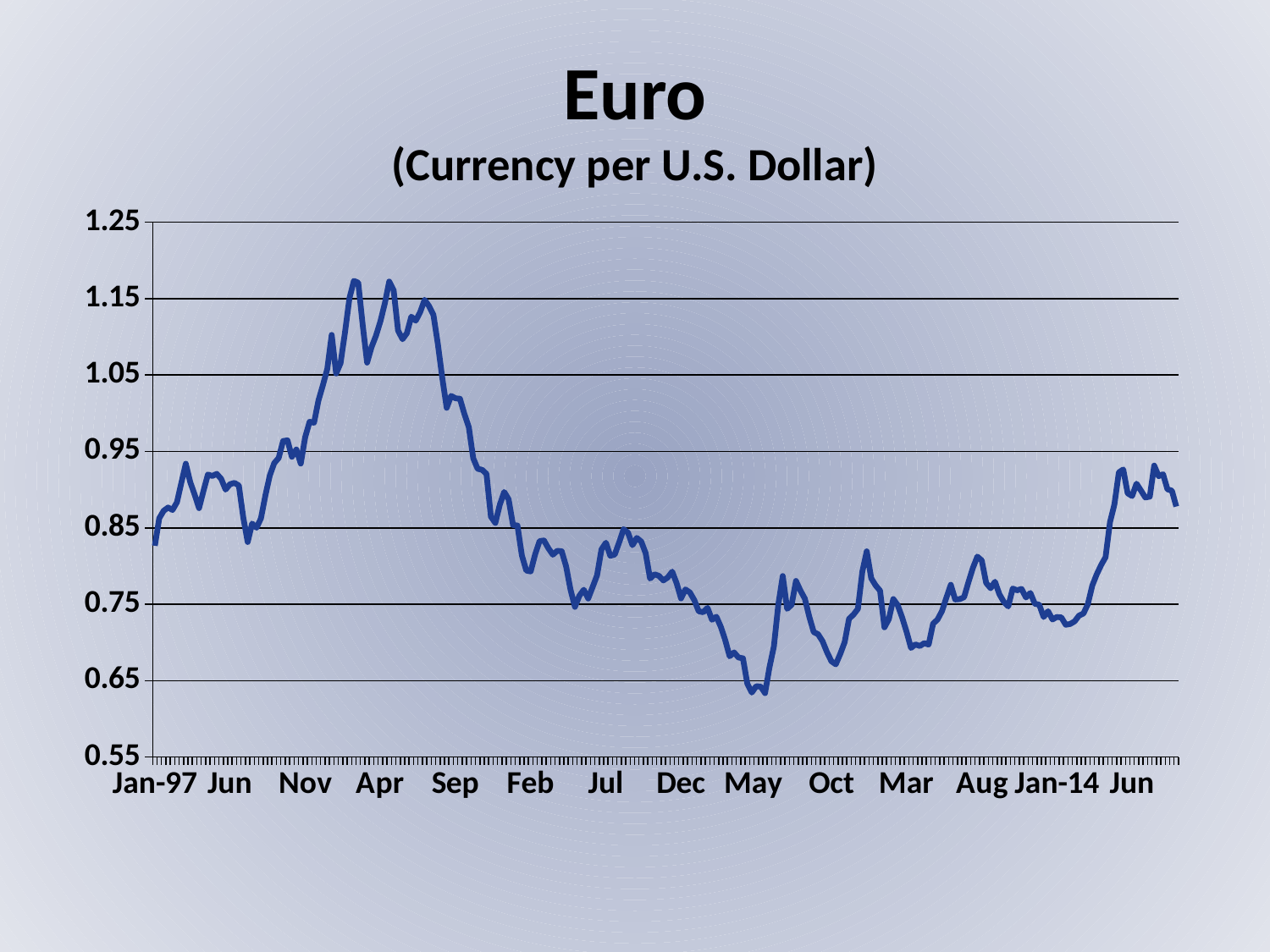
Is the lowest value reached around May greater or less than 0.65? less Around which x-axis label does the line reach its highest value? Apr Does the line rise or fall between Jan-97 and Apr? rise Around which x-axis label does the line reach its lowest value? May What is the title of the chart? Euro Is the value at Oct greater or less than 0.75? less Is the value at Jan-97 greater or less than 0.75? greater What kind of chart is shown on the slide? line chart How many labels are shown on the x axis? 14 What unit does the chart subtitle say the values are in? Currency per U.S. Dollar